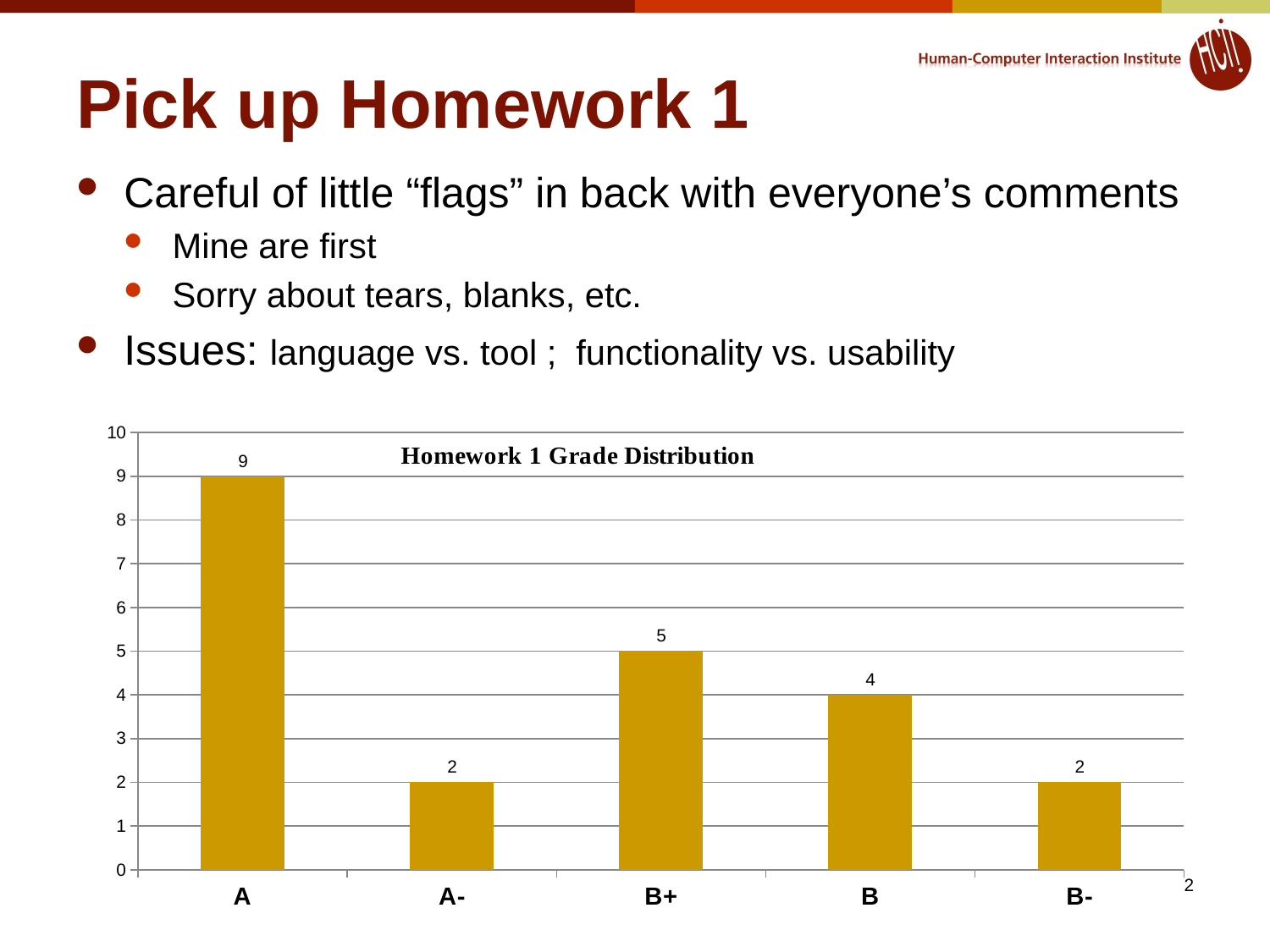
What is the value for grade B+ in the chart? 5 What is the title of the chart on the slide? Homework 1 Grade Distribution Which grade category has the highest value in the chart? A What is the difference between the values for B+ and B? 1 How many grade categories are shown on the x axis of the chart? 5 What kind of chart is shown on the slide? bar chart Is the value for grade A greater or less than 5? greater What is the value for grade B in the chart? 4 What is the value for grade A- in the chart? 2 What is the difference between the values for A and B+? 4 Which is larger, the value for B or the value for B-? B What is the value for grade A in the Homework 1 Grade Distribution chart? 9